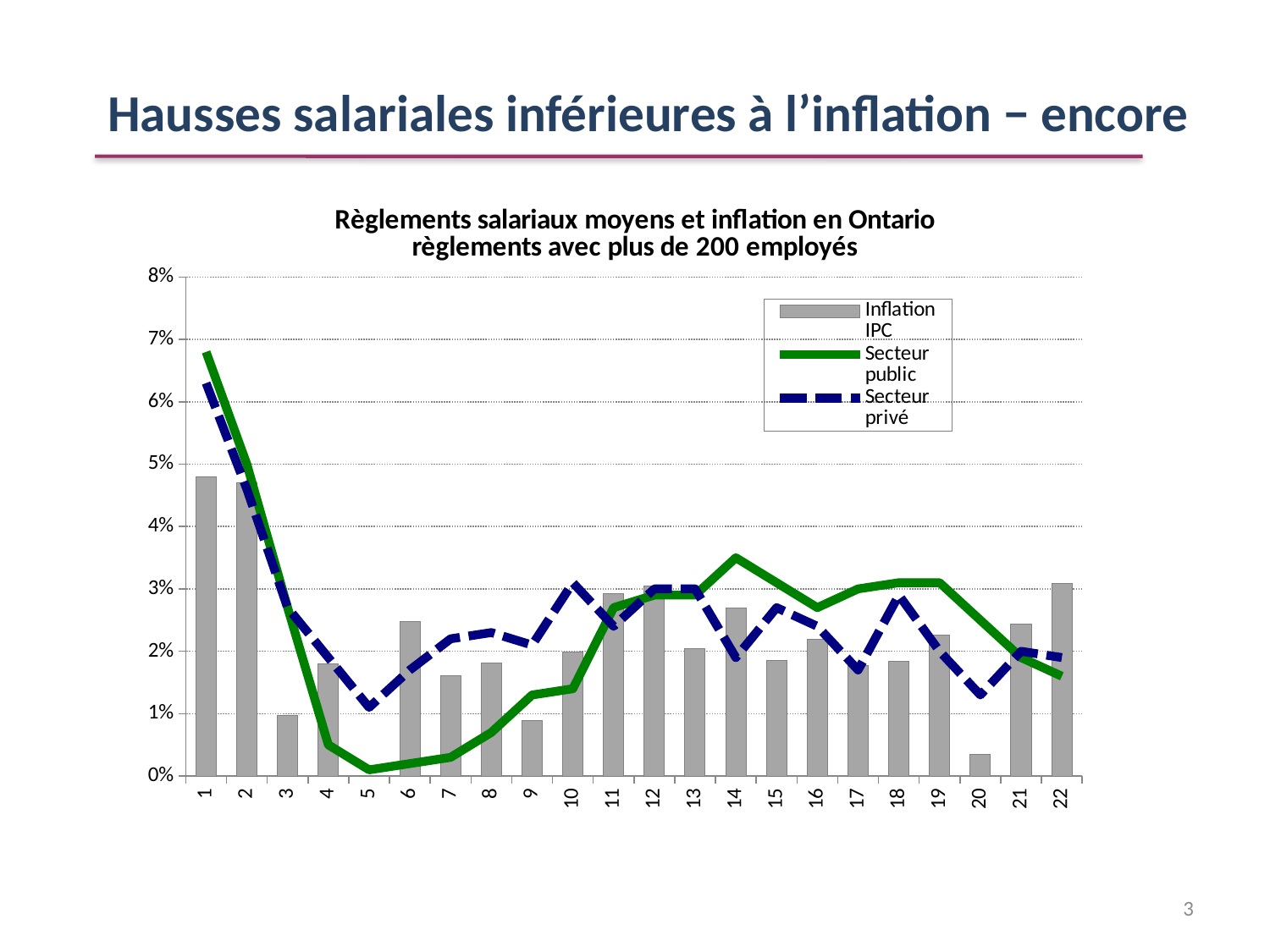
How many series does the legend list? 3 At which category does the Secteur public line reach its highest value? 1 What kind of chart is shown on the slide? A combination bar and line chart Does the Secteur public line rise or fall from category 1 to category 5? fall Which series is drawn as grey bars? Inflation IPC At which category is the Inflation IPC bar lowest? 5 Is the Inflation IPC value for category 1 greater or less than 4%? greater What is the title of the chart? Règlements salariaux moyens et inflation en Ontario règlements avec plus de 200 employés Is the Secteur public value for category 14 greater or less than 3%? greater Is the Secteur public value for category 5 greater or less than 1%? less How many categories are shown along the x axis? 22 At category 5, which is higher: Secteur public or Secteur privé? Secteur privé